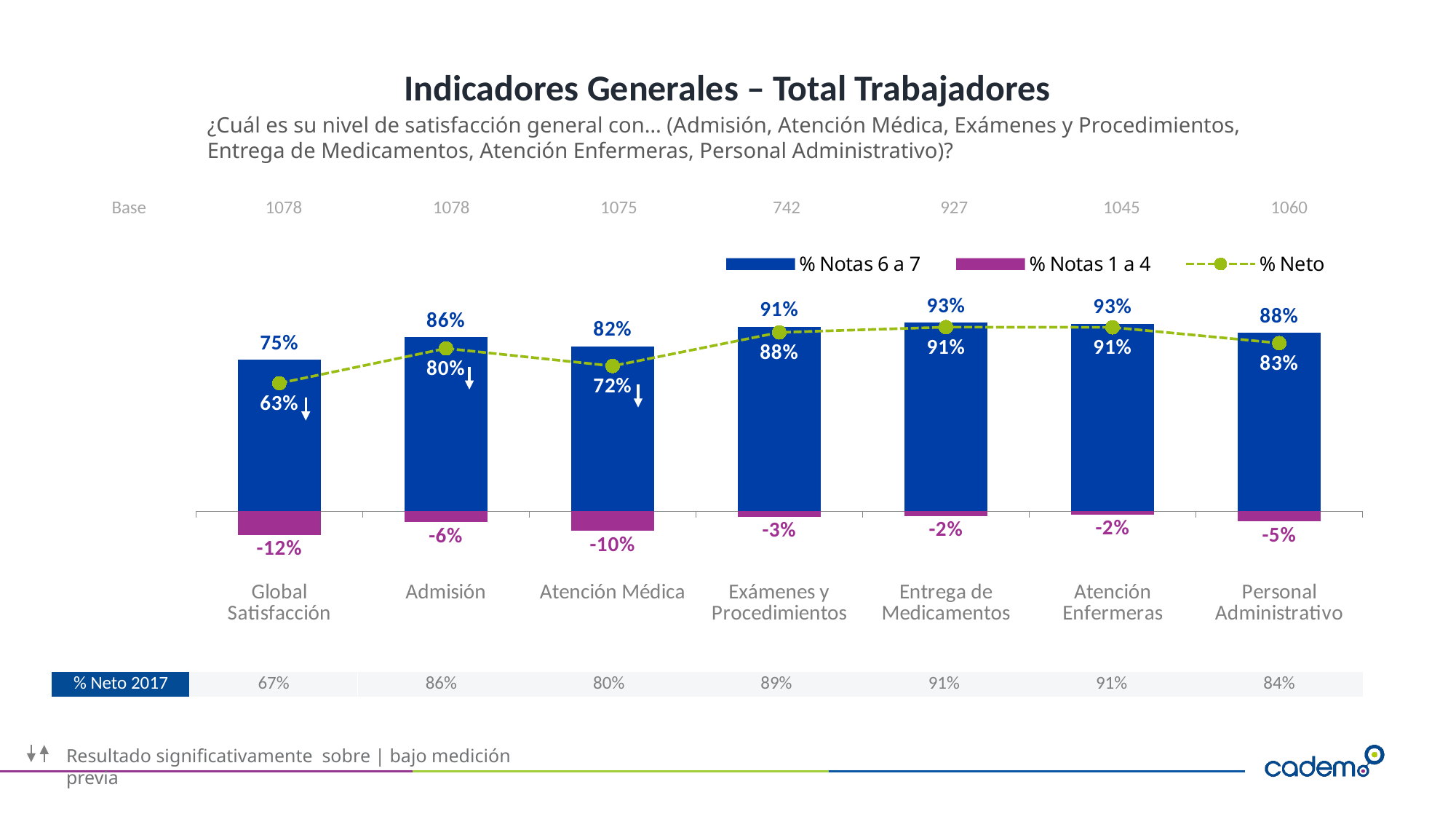
What is the % Neto value for Atención Médica? 72% Which category has the lowest % Notas 6 a 7 value? Global Satisfacción What kind of chart is this? Bar chart with a line What is the base (sample size) for Exámenes y Procedimientos? 742 What is the % Notas 6 a 7 value for Admisión? 86% Which is larger, the % Neto for Admisión or for Personal Administrativo? Personal Administrativo How many series does the legend list? 3 What is the difference between the % Notas 6 a 7 values for Exámenes y Procedimientos and Atención Médica? 9% What is the % Notas 1 a 4 value for Global Satisfacción? -12% What is the % Neto 2017 value for Global Satisfacción shown in the table below the chart? 67% Which category has the highest % Neto value? Entrega de Medicamentos and Atención Enfermeras (91%) How many categories are shown on the x axis? 7